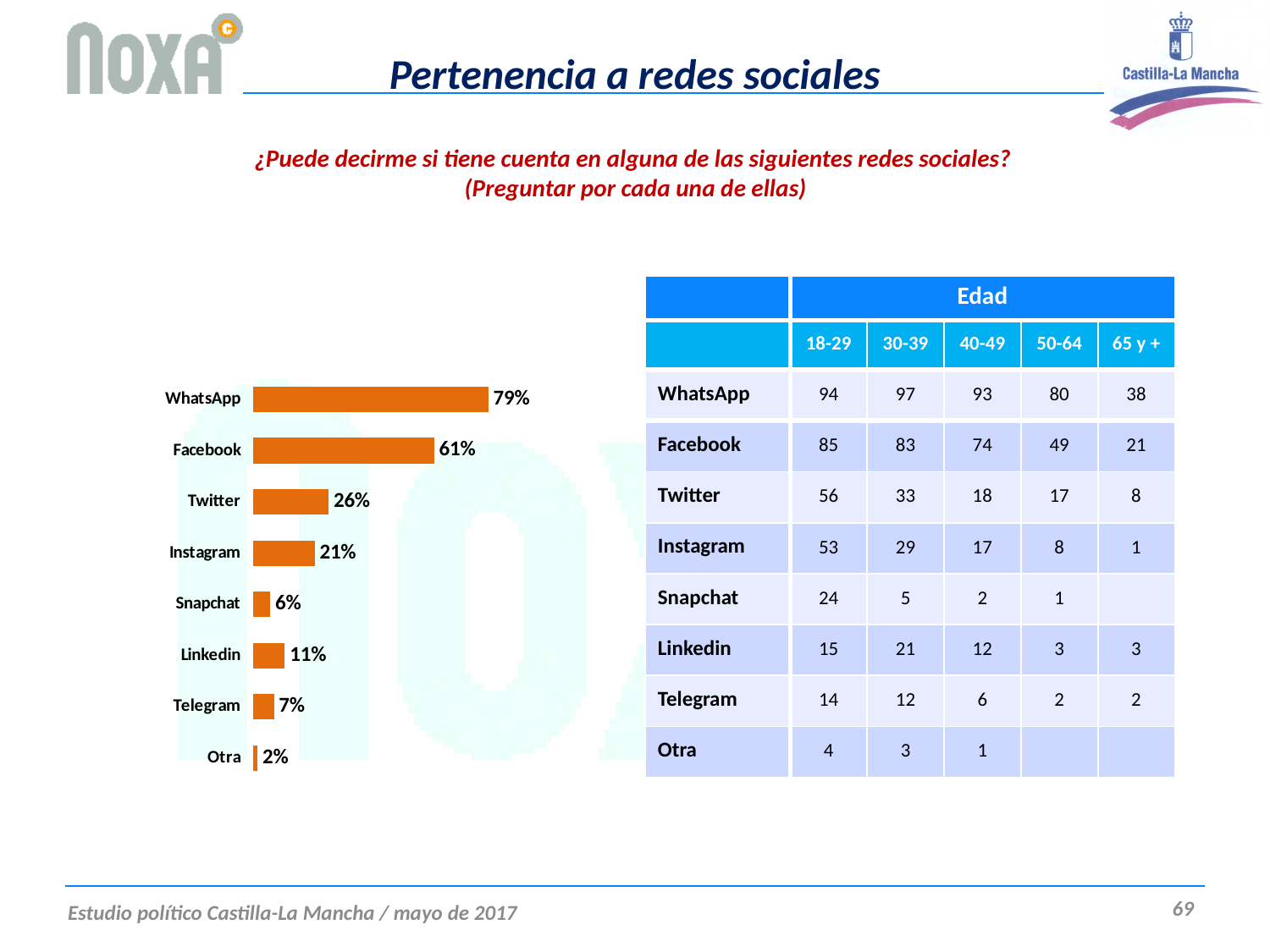
Which is larger in the bar chart, the value for Telegram or the value for Snapchat? Telegram What is the value for Linkedin in the bar chart? 11% Which is larger in the bar chart, the value for Linkedin or the value for Twitter? Twitter What is the difference between the values for WhatsApp and Facebook in the bar chart? 18% Which category has the lowest value in the bar chart? Otra What is the value for Instagram in the bar chart? 21% What is the difference between the values for Twitter and Instagram in the bar chart? 5% What kind of chart is shown on the slide? Bar chart What is the value for WhatsApp in the bar chart? 79% How many categories are shown in the bar chart? 8 Which category has the highest value in the bar chart? WhatsApp What colour are the bars in the chart? Orange